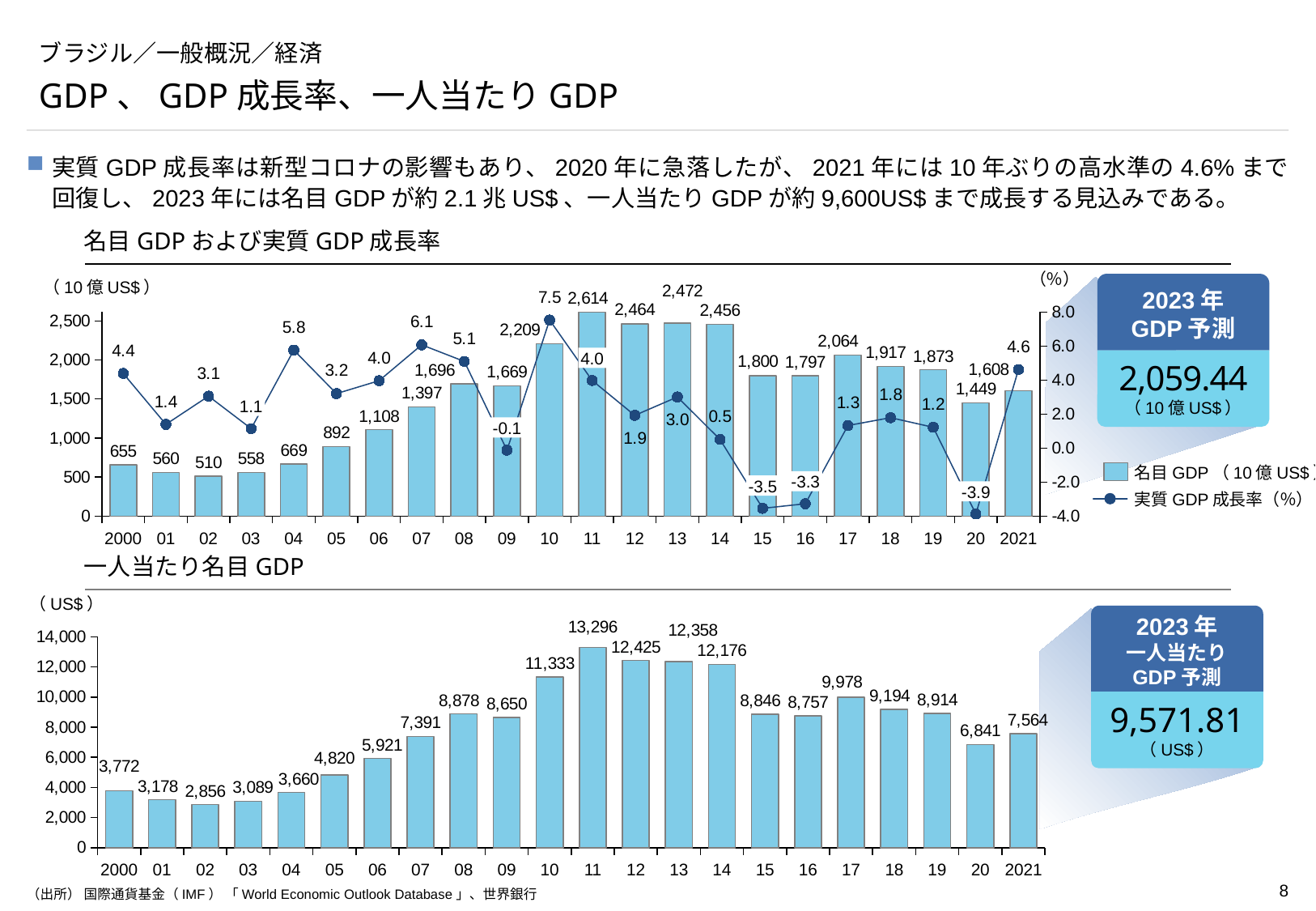
In the top chart (名目GDPおよび実質GDP成長率), what is the real GDP growth rate for 2020? -3.9 In the top chart (名目GDPおよび実質GDP成長率), by how much did nominal GDP increase from 2020 to 2021? 159 How many years are plotted in the bottom chart (一人当たり名目GDP)? 22 How many series does the legend of the top chart (名目GDPおよび実質GDP成長率) list? 2 In the bottom chart (一人当たり名目GDP), what is the difference between the 2011 value and the 2021 value? 5,732 In the top chart (名目GDPおよび実質GDP成長率), which year has the lowest nominal GDP? 2002 In the bottom chart (一人当たり名目GDP), which year has the highest value? 2011 In the bottom chart (一人当たり名目GDP), which year has the larger value, 2017 or 2018? 2017 In the top chart (名目GDPおよび実質GDP成長率), what is the nominal GDP value for 2011? 2,614 In the bottom chart (一人当たり名目GDP), what is the value for 2021? 7,564 What kind of chart is the bottom chart (一人当たり名目GDP)? bar chart In the top chart (名目GDPおよび実質GDP成長率), which year has the highest real GDP growth rate? 2010